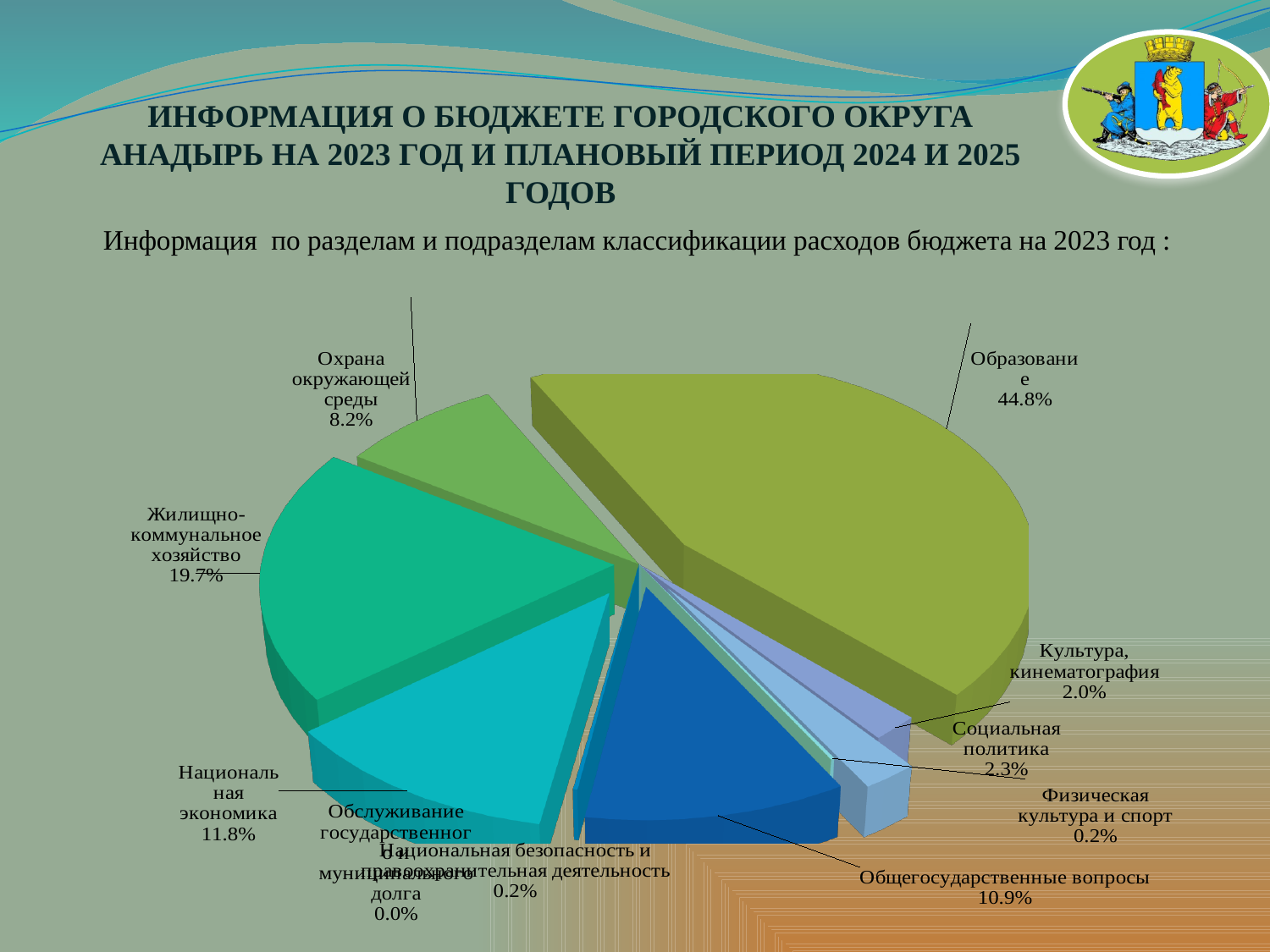
What is the value for Жилищно-коммунальное хозяйство? 19.7% Which category has the largest share of the pie? Образование What is the difference between the shares of Образование and Жилищно-коммунальное хозяйство? 25.1% Which category has the smallest share of the pie? Обслуживание государственного и муниципального долга What is the value for Охрана окружающей среды? 8.2% How many categories are shown in the pie chart? 10 What share of the pie does Образование have? 44.8% What is the value for Социальная политика? 2.3% What is the value for Национальная экономика? 11.8% What kind of chart is shown on the slide? pie chart What is the value for Общегосударственные вопросы? 10.9% Which is larger, the share of Национальная экономика or the share of Общегосударственные вопросы? Национальная экономика